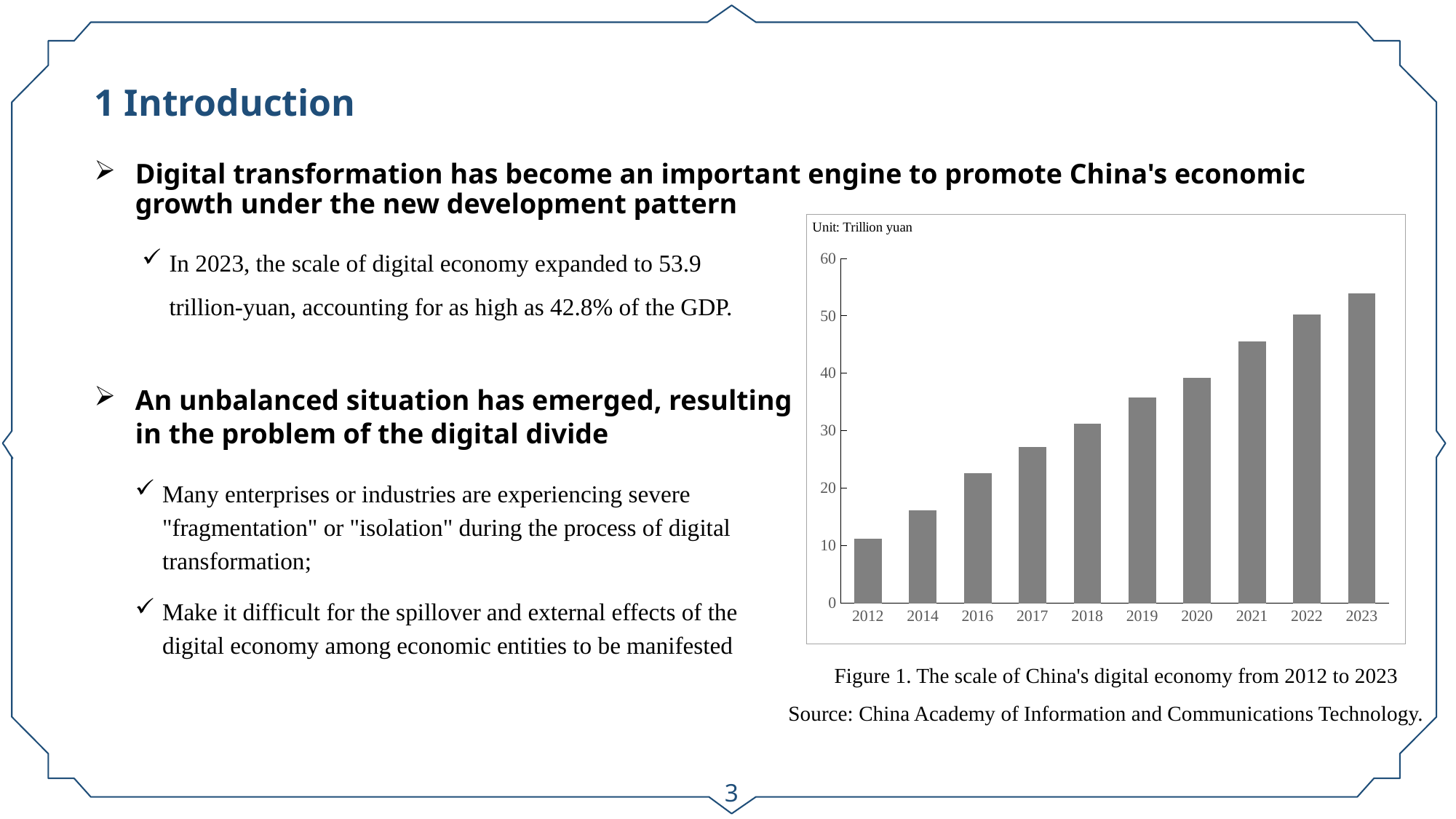
Which is larger, the value for 2016 or the value for 2021? 2021 Which year has the highest value in the chart? 2023 Which year has the lowest value in the chart? 2012 What unit is stated for the values in the chart? Trillion yuan How many years are plotted on the x axis of the chart? 10 What is the source of the data in Figure 1? China Academy of Information and Communications Technology Is the value for 2023 greater or less than 50? greater Is the value for 2012 greater or less than 20? less Do the values rise or fall from 2012 to 2023 along the x axis? rise What kind of chart is shown in Figure 1? bar chart